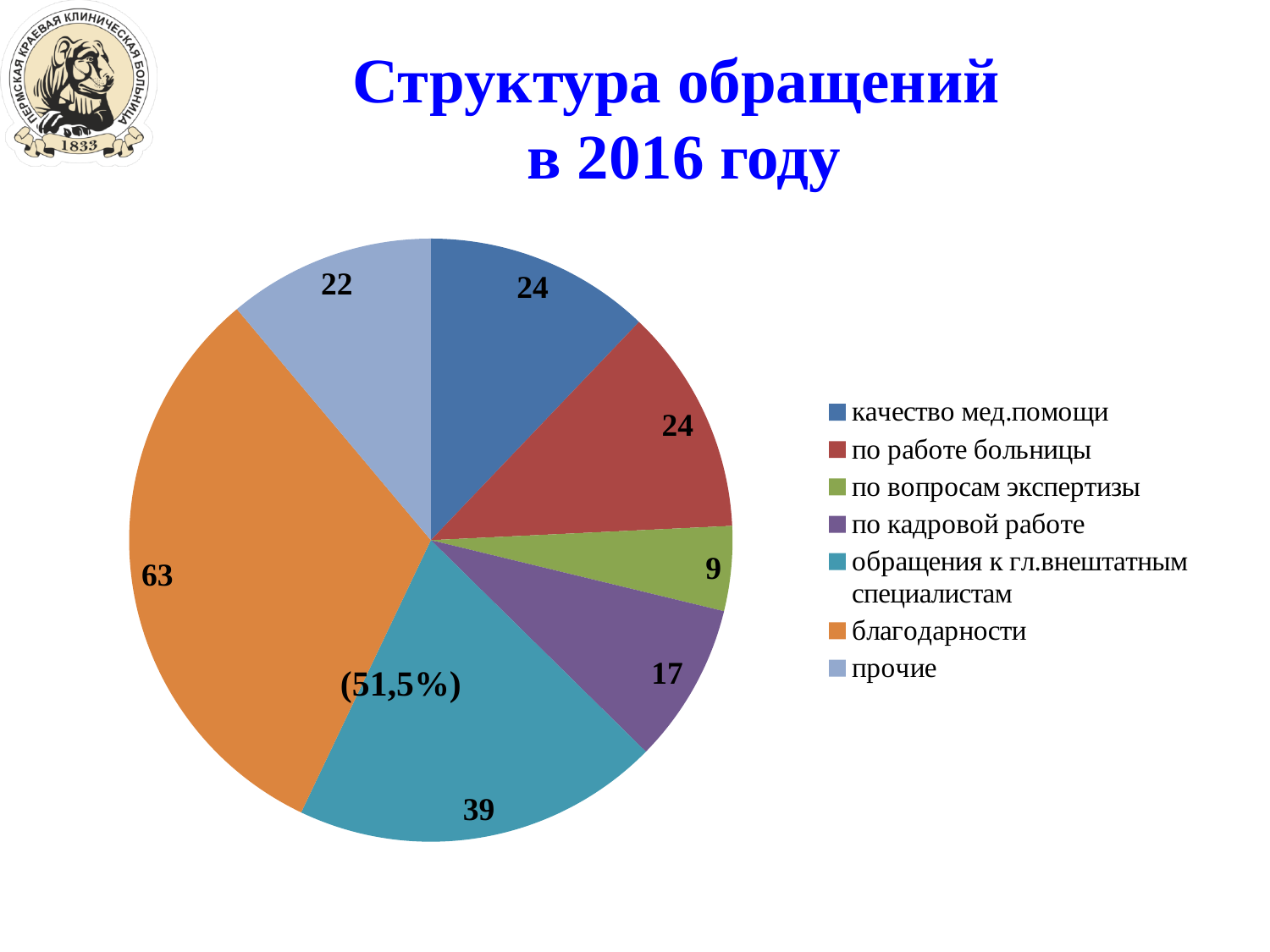
Which category has the largest slice? благодарности Which category has the smallest slice? по вопросам экспертизы What is the value for обращения к гл.внештатным специалистам? 39 What is the value for по вопросам экспертизы? 9 Which is larger, the value for обращения к гл.внештатным специалистам or the value for прочие? обращения к гл.внештатным специалистам What is the value for прочие? 22 What is the value for по кадровой работе? 17 What is the difference between the values for благодарности and обращения к гл.внештатным специалистам? 24 What is the title of the slide? Структура обращений в 2016 году What type of chart is shown on the slide? pie chart What is the value for благодарности? 63 How many categories does the pie chart have? 7